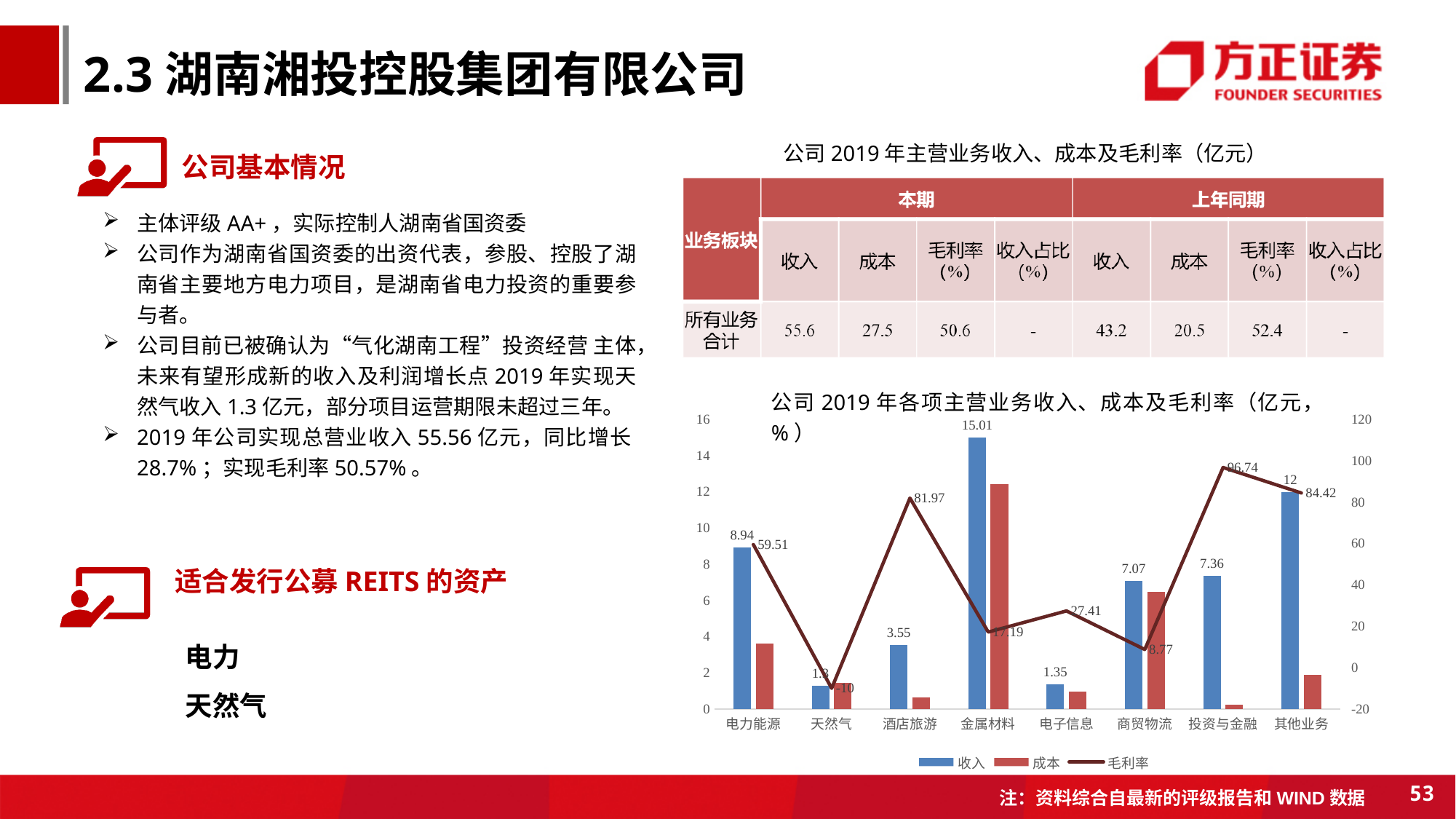
What is the difference between the 收入 of 金属材料 and the 收入 of 其他业务? 3.01 Is the 成本 value for 金属材料 greater or less than 10? greater What is the 毛利率 value for 电力能源 in the chart? 59.51 How many series does the chart's legend list? 3 What kind of chart is shown on the slide? A combined bar and line chart What is the 收入 value for 金属材料 in the chart? 15.01 Which business segment has the lowest 毛利率 in the chart? 天然气 Which has the larger 收入, 商贸物流 or 投资与金融? 投资与金融 Which business segment has the highest 收入 in the chart? 金属材料 Is the 成本 value for 投资与金融 greater or less than 2? less What is the 毛利率 value for 投资与金融 in the chart? 96.74 How many business segments are shown on the x axis of the chart? 8